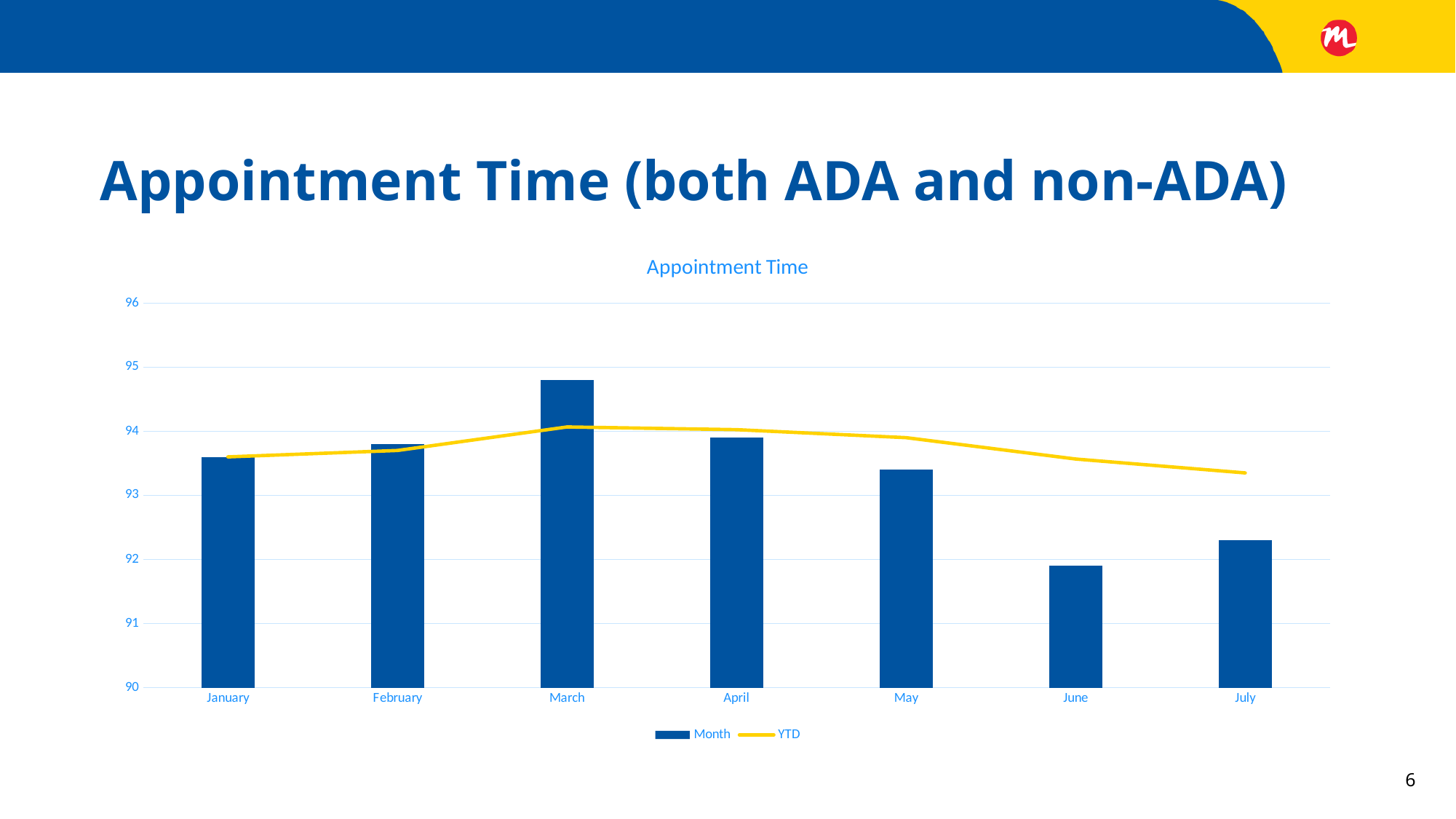
How many months are shown on the x axis of the Appointment Time chart? 7 Which month has the highest Month bar in the Appointment Time chart? March Do the Month bars rise or fall from March to June? fall How many series does the legend of the Appointment Time chart list? 2 Is the Month value for May greater or less than 94? less Is the Month value for March greater or less than 94? greater What are the two legend entries in the Appointment Time chart? Month and YTD Is the Month value for June greater or less than 92? less Which month has the lowest Month bar in the Appointment Time chart? June Which is larger, the Month value for April or the Month value for July? April Which is larger, the Month value for March or the Month value for June? March